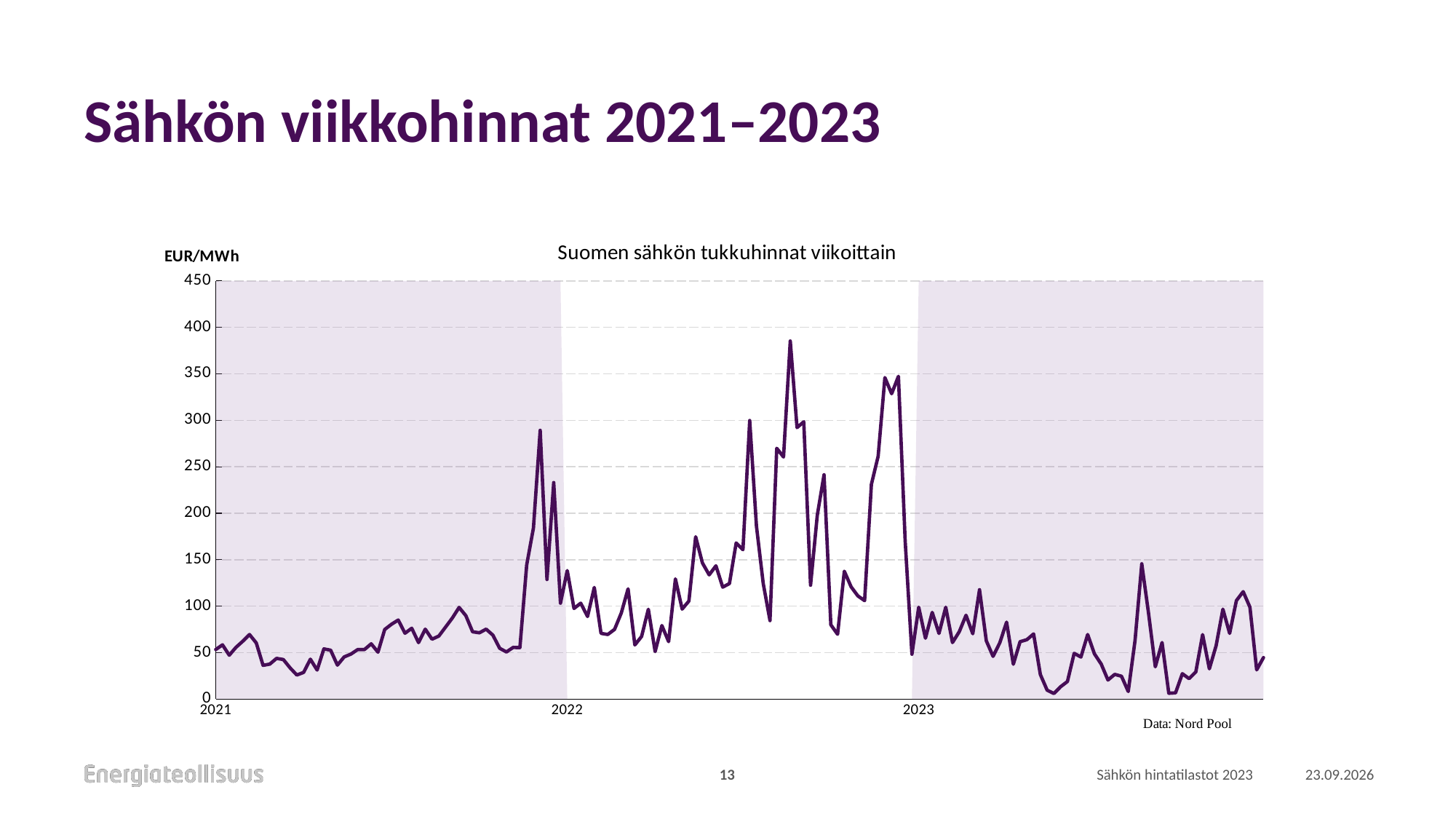
Is the highest weekly price in 2022 greater or less than 350? greater Which year has the highest peak weekly price: 2021, 2022 or 2023? 2022 Which year has a higher peak weekly price, 2021 or 2023? 2021 What unit is shown on the y axis of the chart? EUR/MWh Is the highest weekly price in 2021 greater or less than 250? greater Is the highest weekly price in 2022 greater or less than 400? less What kind of chart is shown on the slide? line chart How many year labels are shown on the x axis? 3 What is the title of the chart? Suomen sähkön tukkuhinnat viikoittain